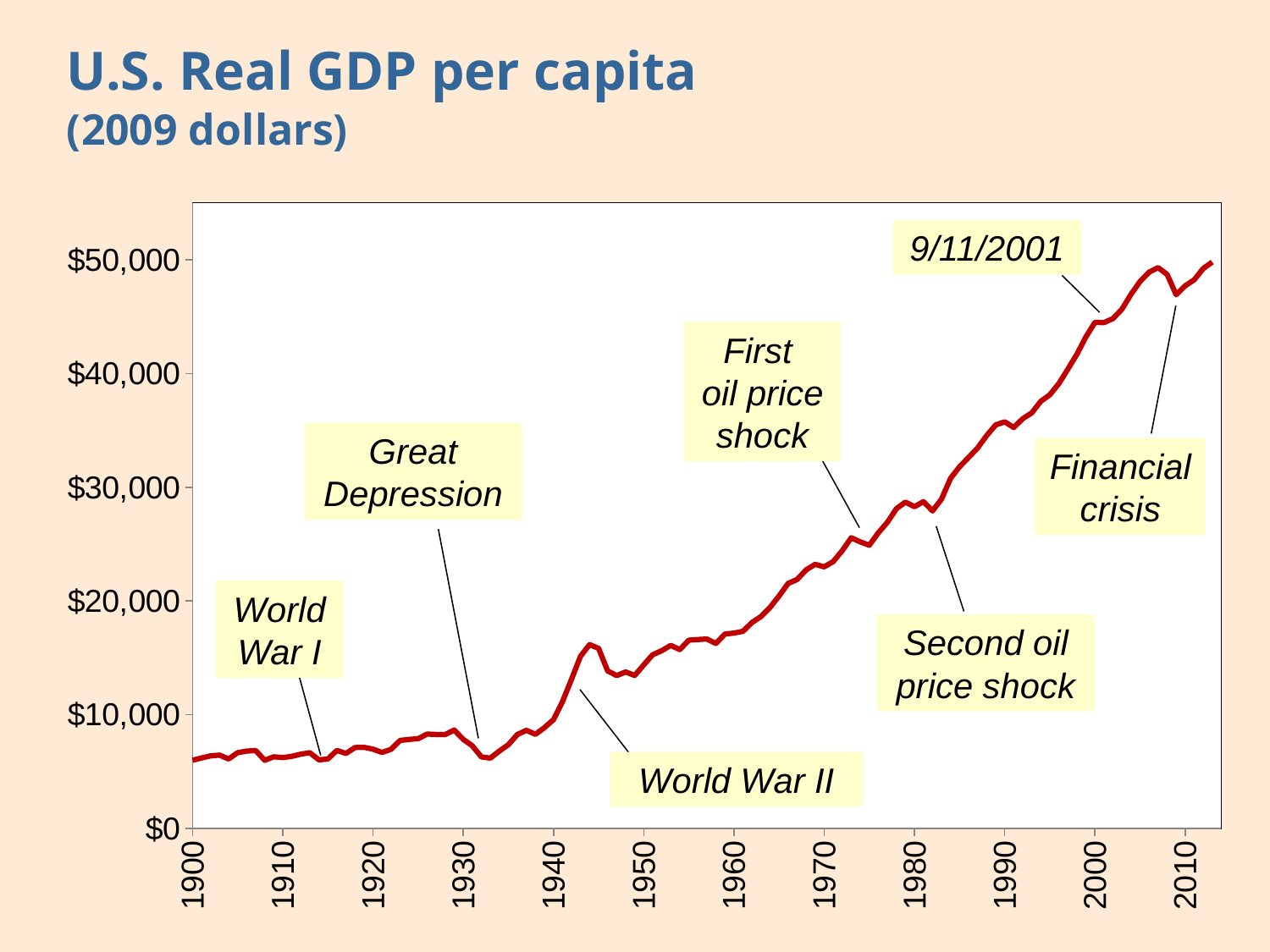
Is the value for 1980 greater or less than $30,000? less Is the value for 1960 greater or less than $20,000? less What is the title of the chart? U.S. Real GDP per capita (2009 dollars) Overall, do the values rise or fall from 1900 to 2010? rise Which year has the larger value, 1900 or 2010? 2010 Is the value for 1990 greater or less than $30,000? greater Which event is annotated on the chart near 1930? Great Depression What kind of chart is shown on the slide? line chart How many year labels are shown on the x axis? 12